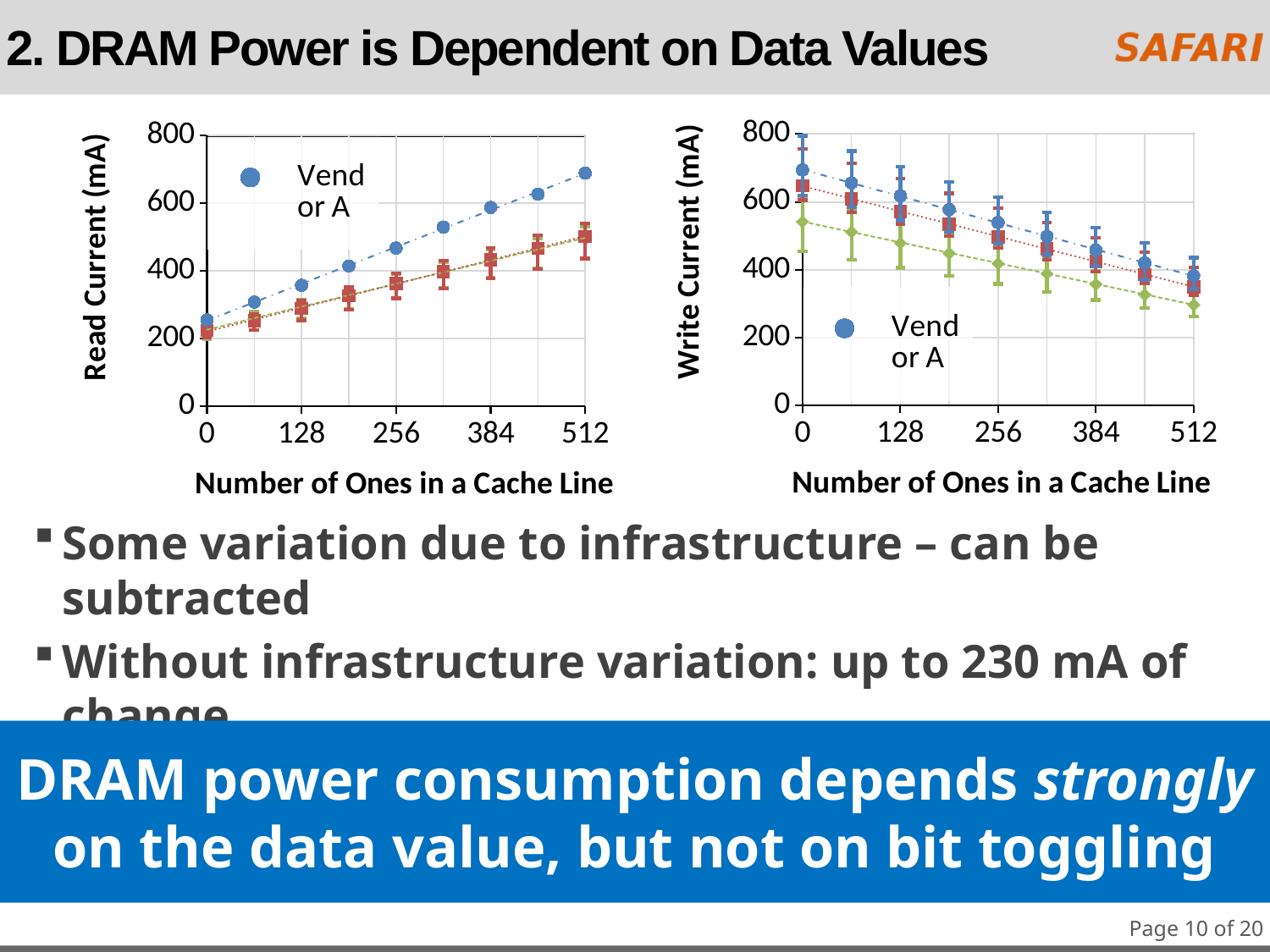
What is the y-axis label of the right chart? Write Current (mA) In the right chart (Write Current), is the Vendor A value larger at 0 ones or at 512 ones? 0 ones What is the x-axis label of the left chart? Number of Ones in a Cache Line In the left chart (Read Current), is the Vendor A value at 512 ones greater or less than 600? greater In the right chart (Write Current), is the Vendor A value at 0 ones greater or less than 600? greater In the right chart (Write Current), is the Vendor A value at 512 ones greater or less than 600? less What kind of chart is the left chart (Read Current)? scatter chart In the right chart (Write Current), does the Vendor A series rise or fall as the number of ones in a cache line increases? fall In the left chart (Read Current), is the Vendor A value larger at 0 ones or at 512 ones? 512 ones How many labeled tick values are shown on the x axis of the left chart (Read Current)? 5 In the left chart (Read Current), does the Vendor A series rise or fall as the number of ones in a cache line increases? rise